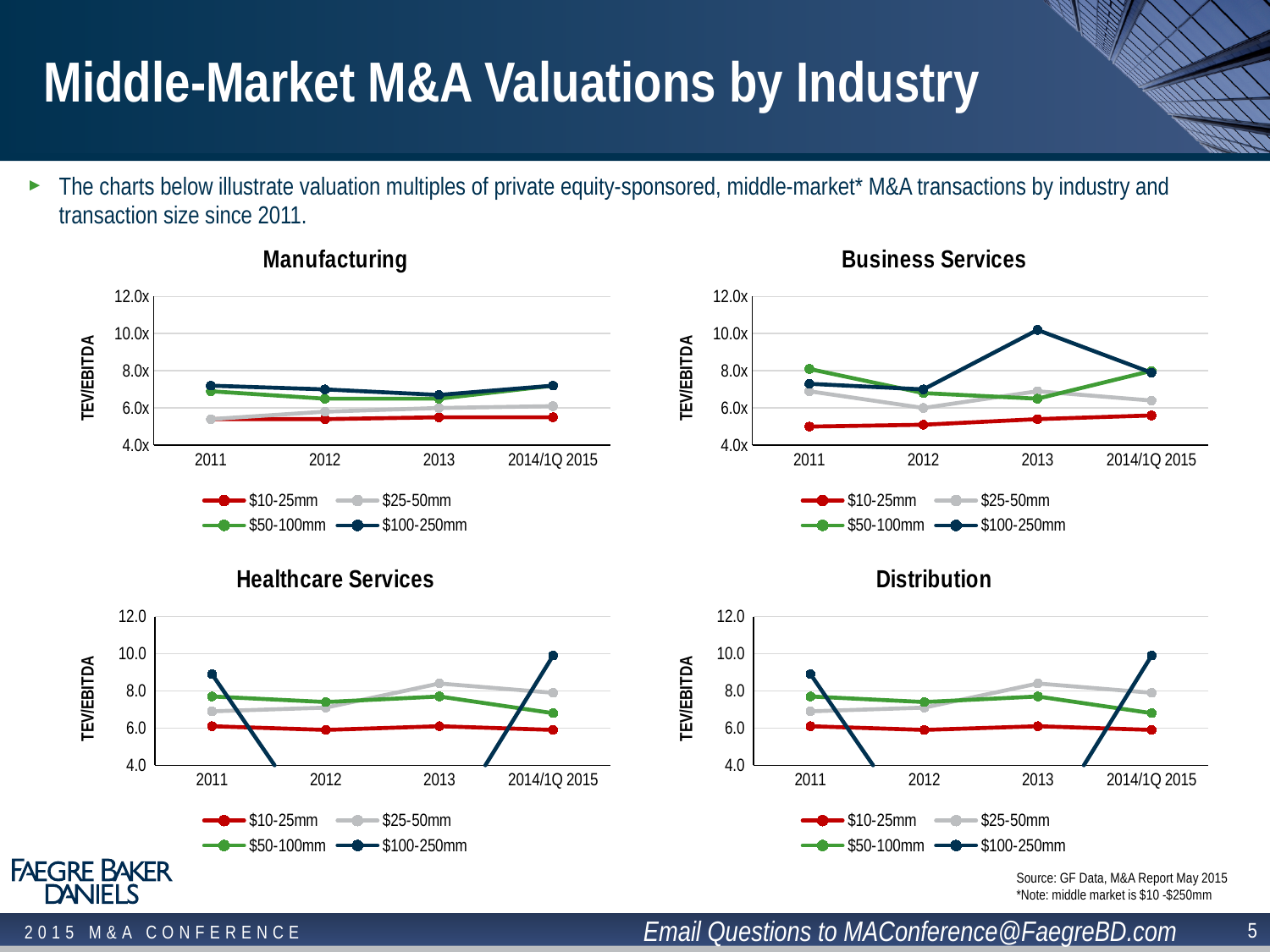
In the Distribution chart, is the value for $50-100mm in 2014/1Q 2015 greater or less than 8.0? less What kind of chart is the Manufacturing chart? line chart How many series does the legend of the Business Services chart list? 4 In the Manufacturing chart, which is larger in 2011: $100-250mm or $10-25mm? $100-250mm In the Healthcare Services chart, is the value for $100-250mm in 2014/1Q 2015 greater or less than 8.0? greater In the Business Services chart, which series has the lowest value in 2011? $10-25mm In the Business Services chart, which series has the highest value in 2013? $100-250mm How many time periods are shown on the x axis of the Healthcare Services chart? 4 In the Manufacturing chart, is the value for $10-25mm in 2011 greater or less than 6.0x? less What is the y-axis label on the Distribution chart? TEV/EBITDA In the Business Services chart, which is larger in 2011: $50-100mm or $10-25mm? $50-100mm